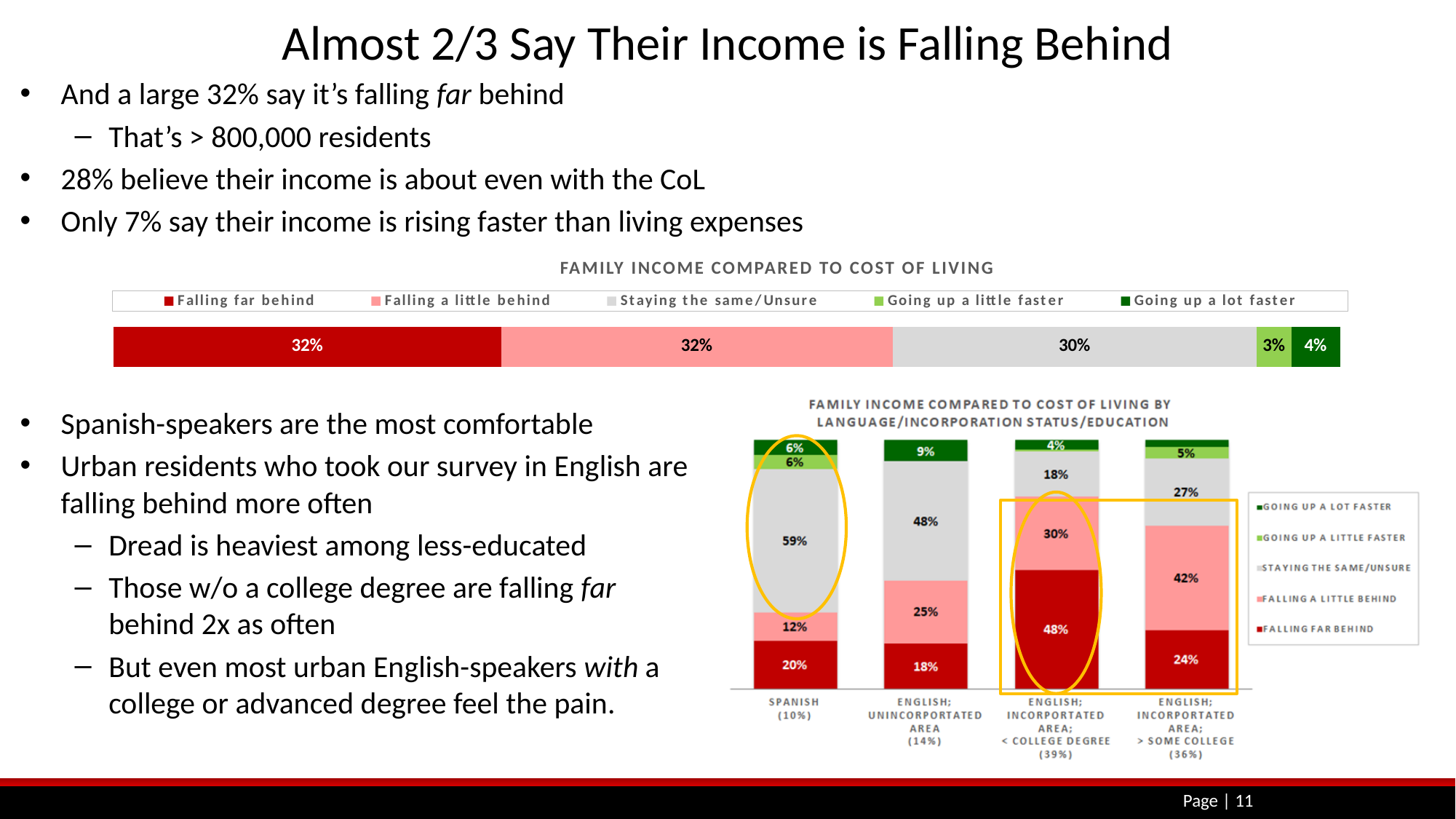
What type of chart is the bottom chart by language/incorporation status/education? Stacked bar chart In the bottom chart by language/incorporation status/education, what percentage of the 'English; Incorporated Area; < College Degree' group is 'Falling far behind'? 48% In the top chart 'Family Income Compared to Cost of Living', what percentage is shown for 'Falling far behind'? 32% In the bottom chart by language/incorporation status/education, what is the difference in 'Falling far behind' between the '< College Degree' group and the '> Some College' group? 24% In the bottom chart by language/incorporation status/education, how many groups are shown on the x axis? 4 In the bottom chart by language/incorporation status/education, which is larger: 'Falling a little behind' for 'English; Unincorporated Area' or for 'English; Incorporated Area; > Some College'? English; Incorporated Area; > Some College In the bottom chart by language/incorporation status/education, which group has the highest 'Falling far behind' percentage? English; Incorporated Area; < College Degree In the bottom chart by language/incorporation status/education, what percentage of the Spanish group is 'Staying the same/Unsure'? 59% In the top chart 'Family Income Compared to Cost of Living', which segment is the smallest? Going up a little faster In the top chart 'Family Income Compared to Cost of Living', what is the difference between 'Staying the same/Unsure' and 'Going up a little faster'? 27% In the top chart 'Family Income Compared to Cost of Living', what percentage is shown for 'Going up a lot faster'? 4% In the top chart 'Family Income Compared to Cost of Living', how many series does the legend list? 5